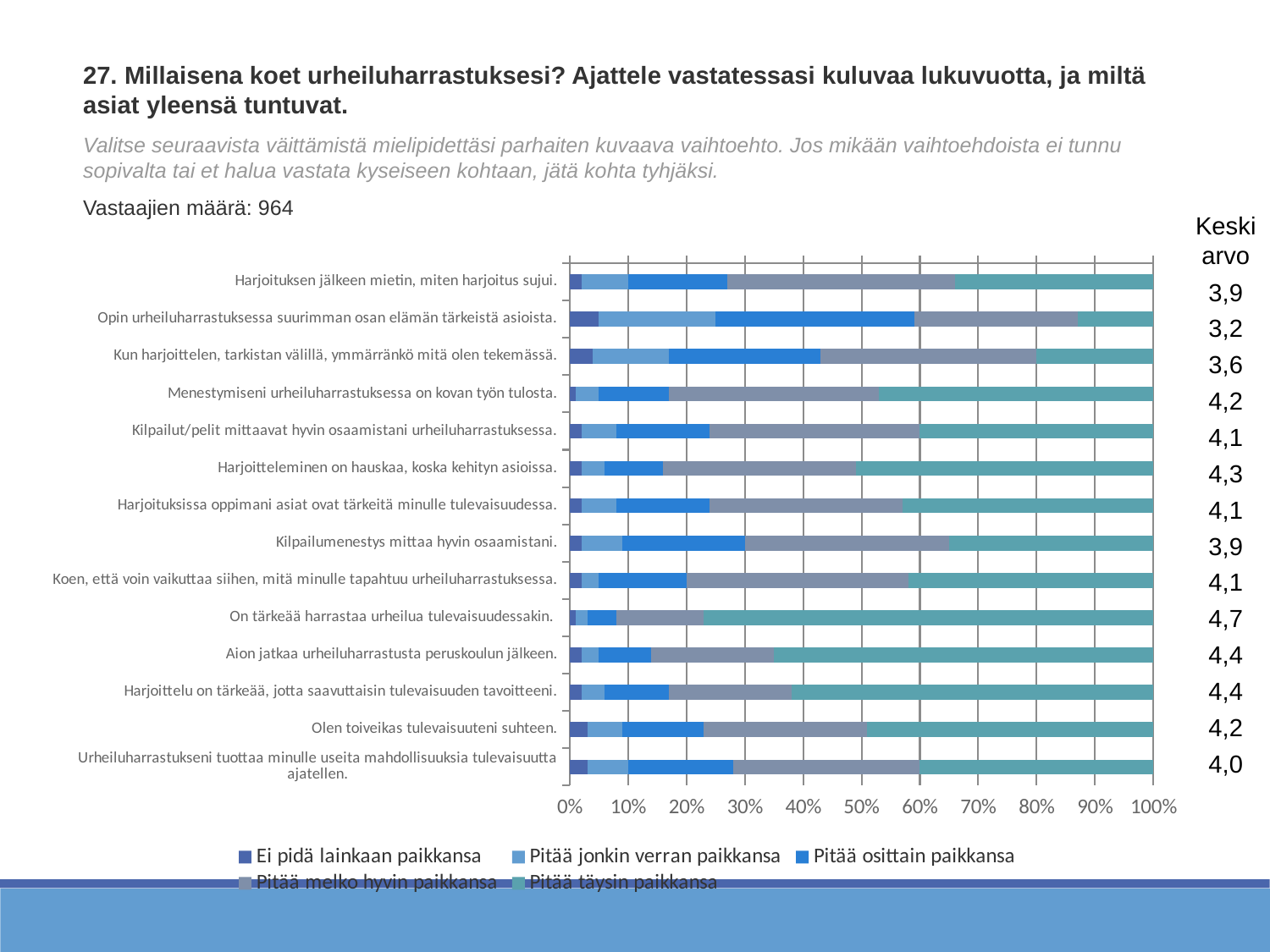
What is the Keskiarvo value shown for "On tärkeää harrastaa urheilua tulevaisuudessakin."? 4,7 What is the difference between the highest and lowest Keskiarvo values? 1,5 Which statement has the lowest Keskiarvo value? Opin urheiluharrastuksessa suurimman osan elämän tärkeistä asioista. Is the "Pitää täysin paikkansa" share for "Opin urheiluharrastuksessa suurimman osan elämän tärkeistä asioista." greater or less than 20%? less Which has a higher Keskiarvo value: "Harjoitteleminen on hauskaa, koska kehityn asioissa." or "Kilpailumenestys mittaa hyvin osaamistani."? Harjoitteleminen on hauskaa, koska kehityn asioissa. What kind of chart is shown on the slide? Stacked bar chart What is the Keskiarvo value shown for "Olen toiveikas tulevaisuuteni suhteen."? 4,2 What is the Keskiarvo value shown for "Opin urheiluharrastuksessa suurimman osan elämän tärkeistä asioista."? 3,2 Is the "Pitää täysin paikkansa" share for "On tärkeää harrastaa urheilua tulevaisuudessakin." greater or less than 70%? greater Which statement has the highest Keskiarvo value? On tärkeää harrastaa urheilua tulevaisuudessakin. How many series does the legend list? 5 How many statements (categories) are plotted in the chart? 14